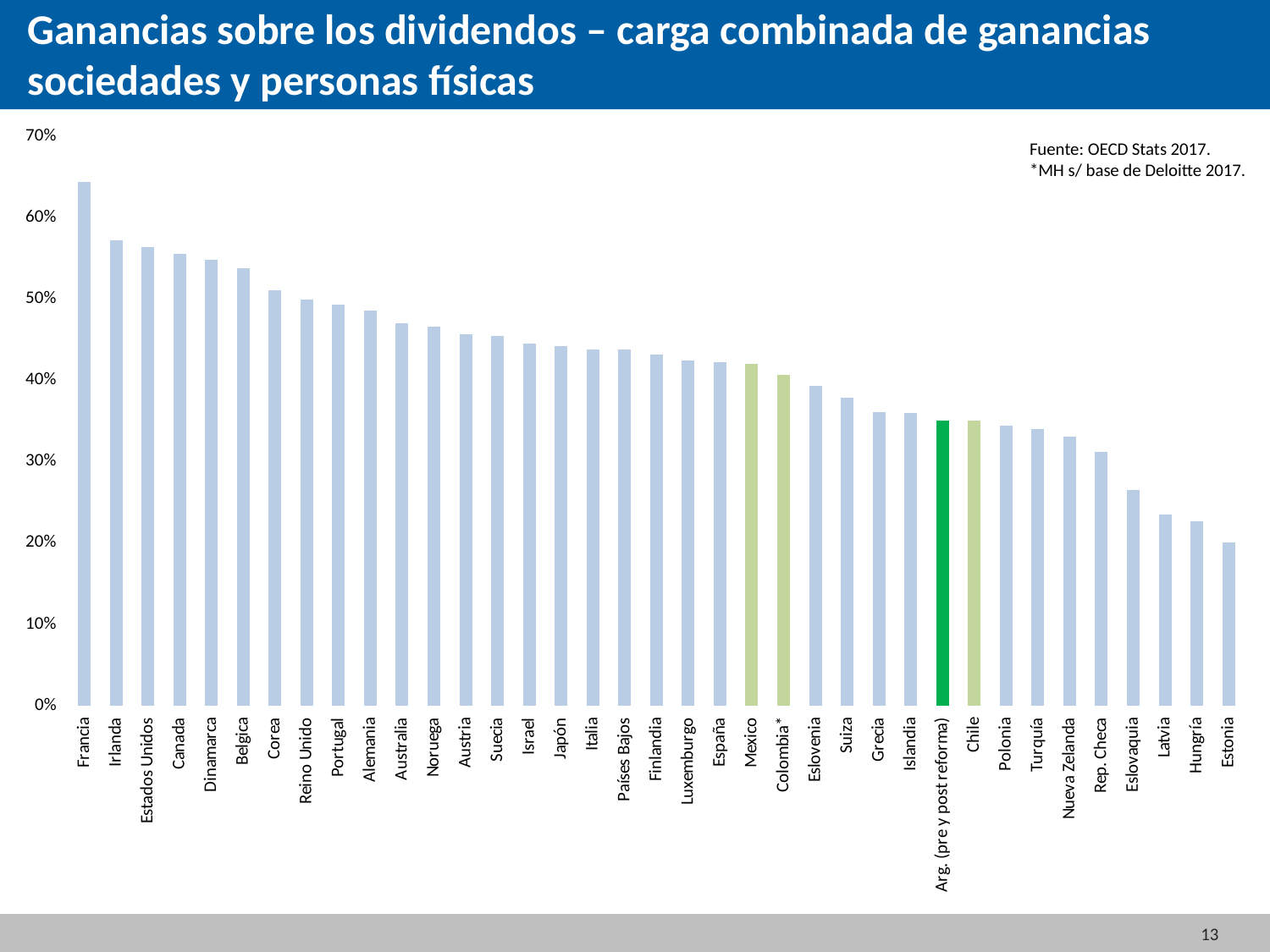
Which country has the highest value in the chart? Francia What source is cited for the chart data? OECD Stats 2017 Do the values rise or fall moving from left to right along the x axis? fall What kind of chart is shown on the slide? bar chart Is the value for Mexico greater or less than 40%? greater Is the value for Francia greater or less than 60%? greater Is the value for Eslovaquia greater or less than 30%? less Which has a larger value, Mexico or Chile? Mexico How many countries (bars) are shown in the chart? 37 Which country has the lowest value in the chart? Estonia